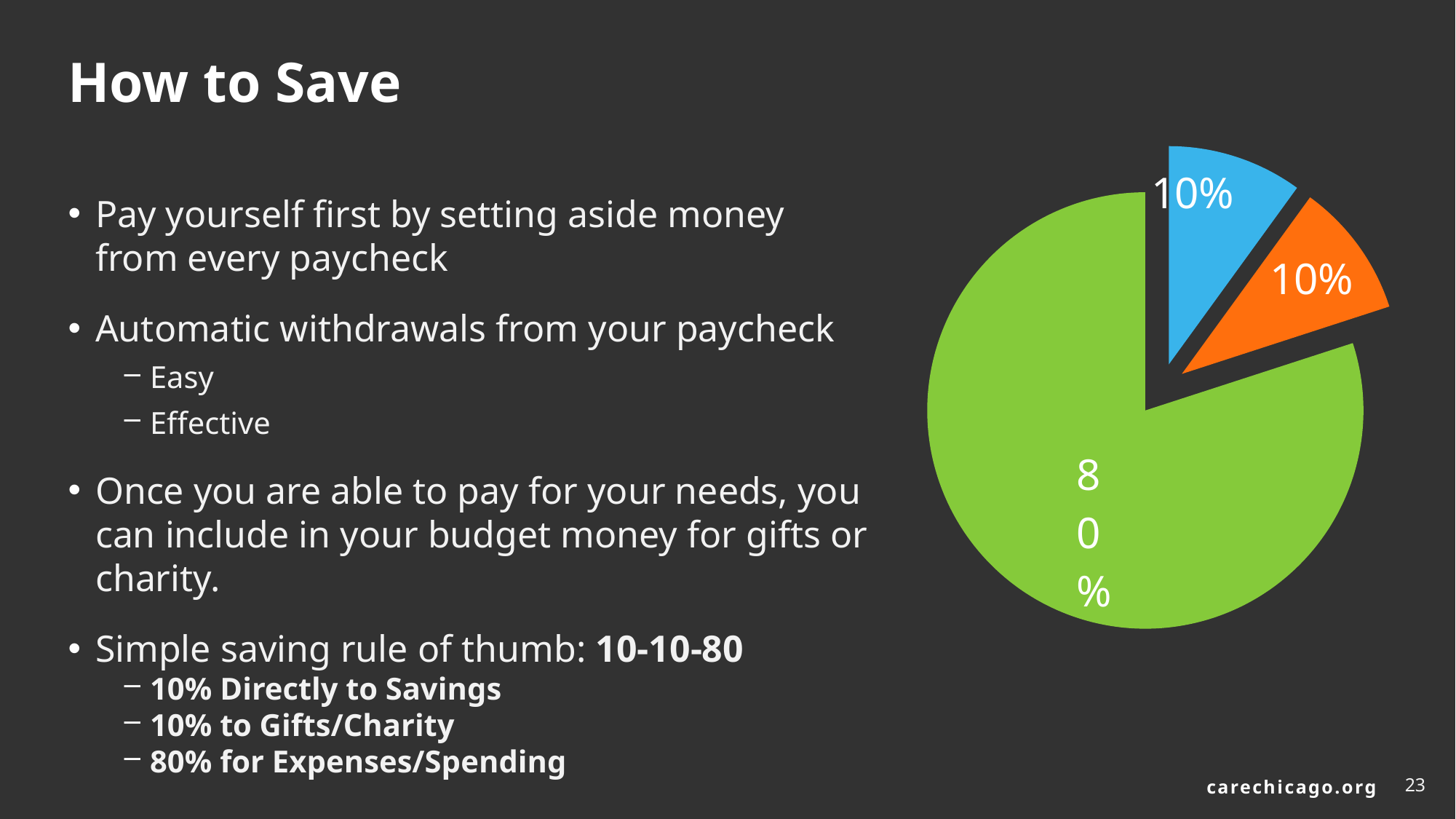
What share of the pie does the green slice represent? 80% Is the green slice larger or smaller than the orange slice? larger What is the difference between the green slice's share and the blue slice's share? 70% What share of the pie does the orange slice represent? 10% What share of the pie does the blue slice represent? 10% What kind of chart is shown on the slide? pie chart How many slices does the pie chart have? 3 Which colour slice is the largest in the pie chart? green What is the combined share of the blue and orange slices? 20% Which two slices of the pie chart are pulled out from the rest? the blue and orange slices Is the share of the green slice greater or less than 50%? greater Does the pie chart have a legend? No